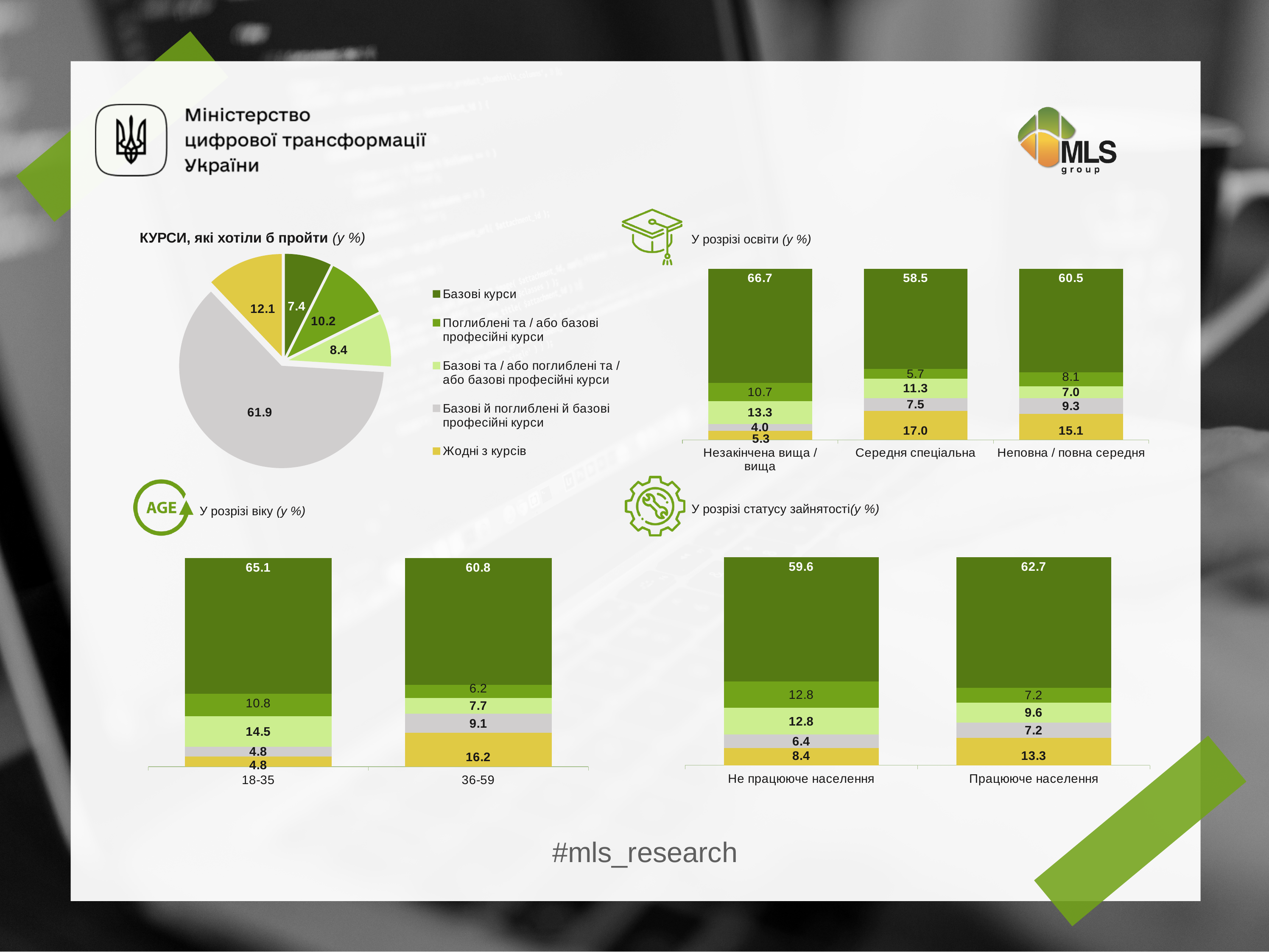
What type of chart is 'У розрізі статусу зайнятості'? Stacked bar chart How many categories does the legend of the pie chart 'КУРСИ, які хотіли б пройти' list? 5 In the chart 'У розрізі освіти', what is the value of the top dark green segment for 'Незакінчена вища / вища'? 66.7 In the chart 'У розрізі віку', what is the value of the bottom yellow segment for '36-59'? 16.2 In the pie chart 'КУРСИ, які хотіли б пройти', which category has the smallest slice? Базові курси In the chart 'У розрізі освіти', what is the value of the bottom yellow segment for 'Середня спеціальна'? 17.0 In the chart 'У розрізі статусу зайнятості', what is the value of the bottom yellow segment for 'Працююче населення'? 13.3 In the pie chart 'КУРСИ, які хотіли б пройти', what share is shown for 'Жодні з курсів'? 12.1 In the pie chart 'КУРСИ, які хотіли б пройти', which category has the largest slice? Базові й поглиблені й базові професійні курси In the chart 'У розрізі віку', what is the difference between the top dark green segment values for '18-35' and '36-59'? 4.3 In the chart 'У розрізі статусу зайнятості', which category has the larger top dark green segment, 'Не працююче населення' or 'Працююче населення'? Працююче населення In the chart 'У розрізі освіти', how many education categories are shown on the x axis? 3